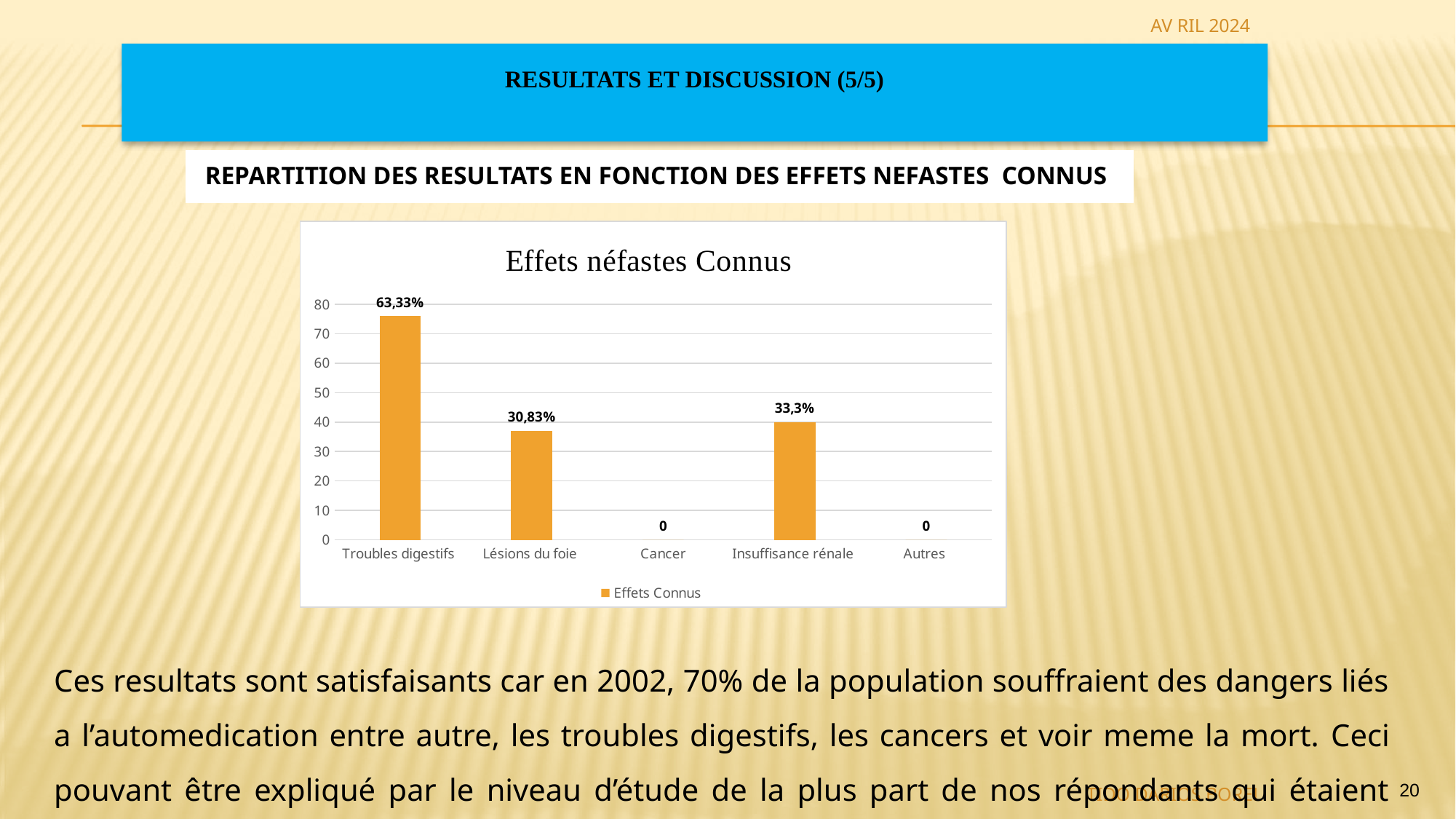
What value is shown for Troubles digestifs? 63,33% What type of chart is shown on the slide? Bar chart What value is shown for Insuffisance rénale? 33,3% What series name does the legend list? Effets Connus Is the value for Troubles digestifs greater or less than 50? greater What is the difference between the values for Troubles digestifs and Lésions du foie? 32,5% What is the title of the chart? Effets néfastes Connus Which is larger, the value for Insuffisance rénale or the value for Lésions du foie? Insuffisance rénale What value is shown for Lésions du foie? 30,83% What value is shown for Cancer? 0 How many categories are shown on the x axis? 5 Which category has the highest value? Troubles digestifs